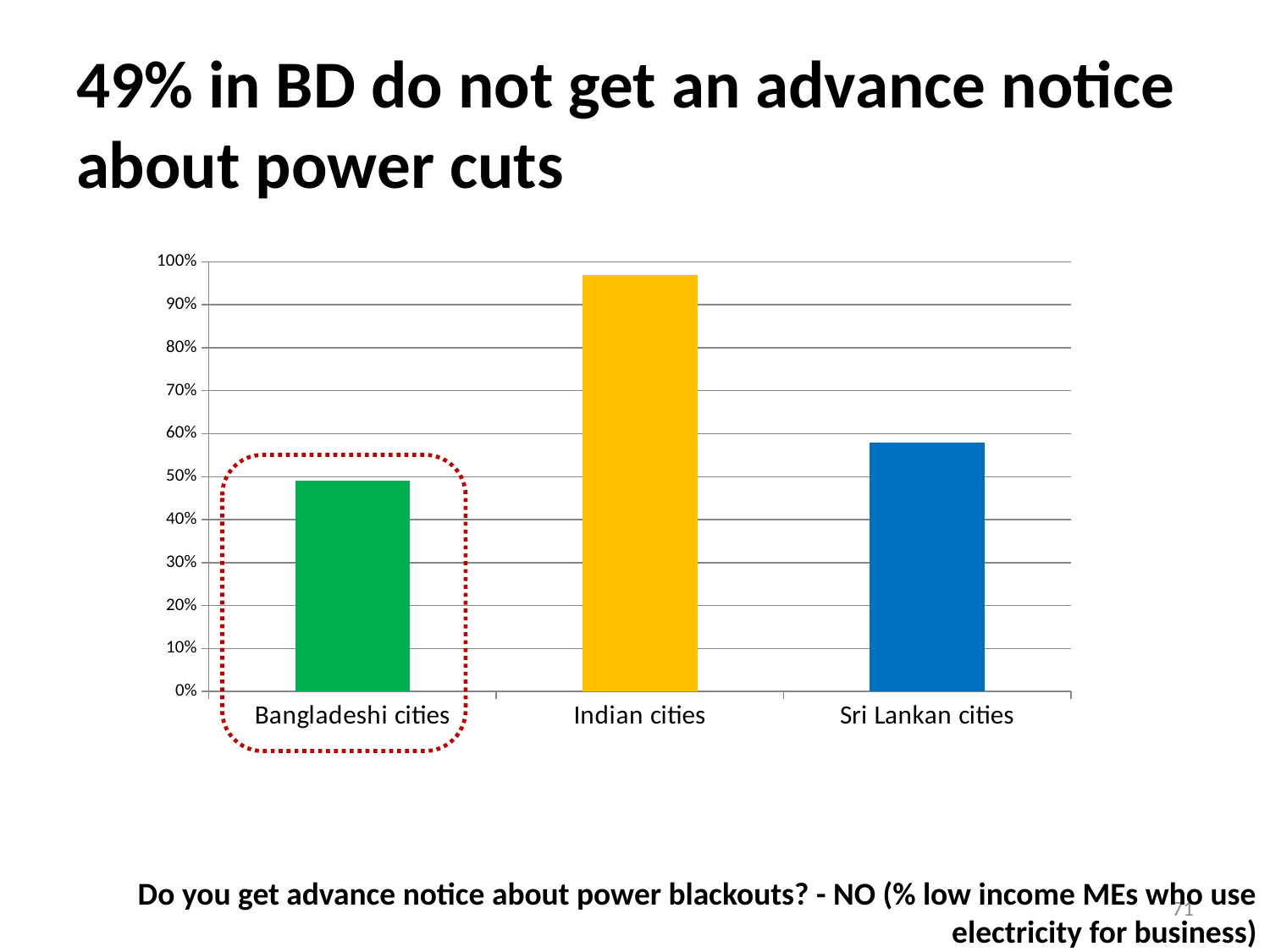
Is the value for Sri Lankan cities greater or less than 50%? greater Which category has the lowest value in the chart? Bangladeshi cities Which is larger, the value for Indian cities or the value for Sri Lankan cities? Indian cities Is the value for Bangladeshi cities greater or less than 60%? less What kind of chart is shown on the slide? bar chart How many categories are plotted in the chart? 3 According to the slide, what percentage of low income MEs in Bangladeshi cities do not get advance notice about power cuts? 49% Which category's bar is highlighted with a dotted red outline? Bangladeshi cities Which is larger, the value for Bangladeshi cities or the value for Sri Lankan cities? Sri Lankan cities Is the value for Indian cities greater or less than 90%? greater Which category has the highest value in the chart? Indian cities